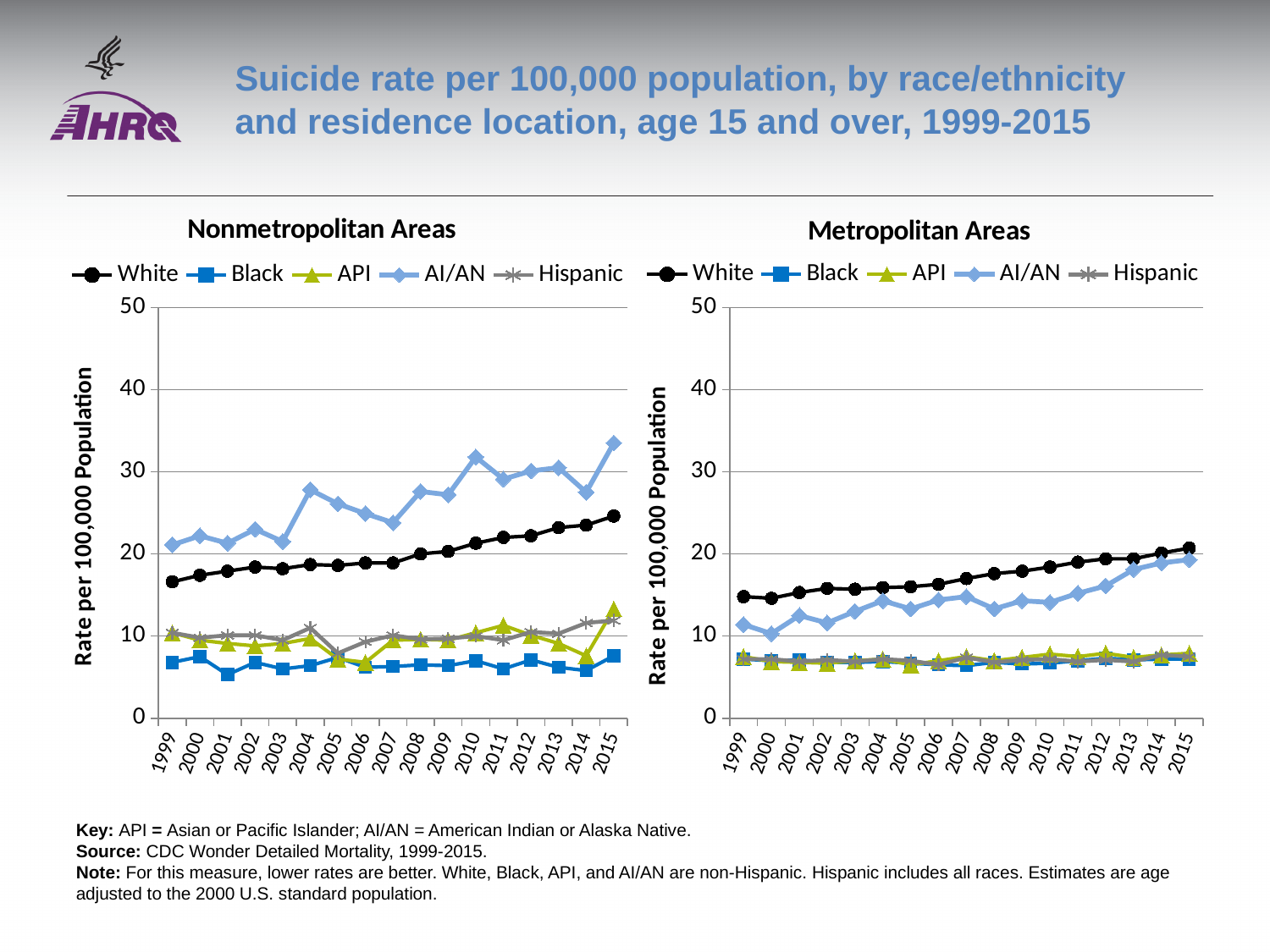
In the Metropolitan Areas chart, which series has the highest value in 1999? White In the Nonmetropolitan Areas chart, which series has the highest value in 2015? AI/AN What is the y-axis title of the Metropolitan Areas chart? Rate per 100,000 Population What kind of chart is the Nonmetropolitan Areas chart? line chart In the Nonmetropolitan Areas chart, is the value for AI/AN in 2015 greater or less than 30? greater In the Metropolitan Areas chart, does the White series rise or fall from 1999 to 2015? rise In the Metropolitan Areas chart, is the value for White in 1999 greater or less than 20? less How many series does the legend of the Metropolitan Areas chart list? 5 How many years are plotted along the x axis of the Nonmetropolitan Areas chart? 17 In the Nonmetropolitan Areas chart, is the value for White in 2015 greater or less than 20? greater Which is larger, the AI/AN value in 2015 in the Nonmetropolitan Areas chart or the AI/AN value in 2015 in the Metropolitan Areas chart? Nonmetropolitan Areas